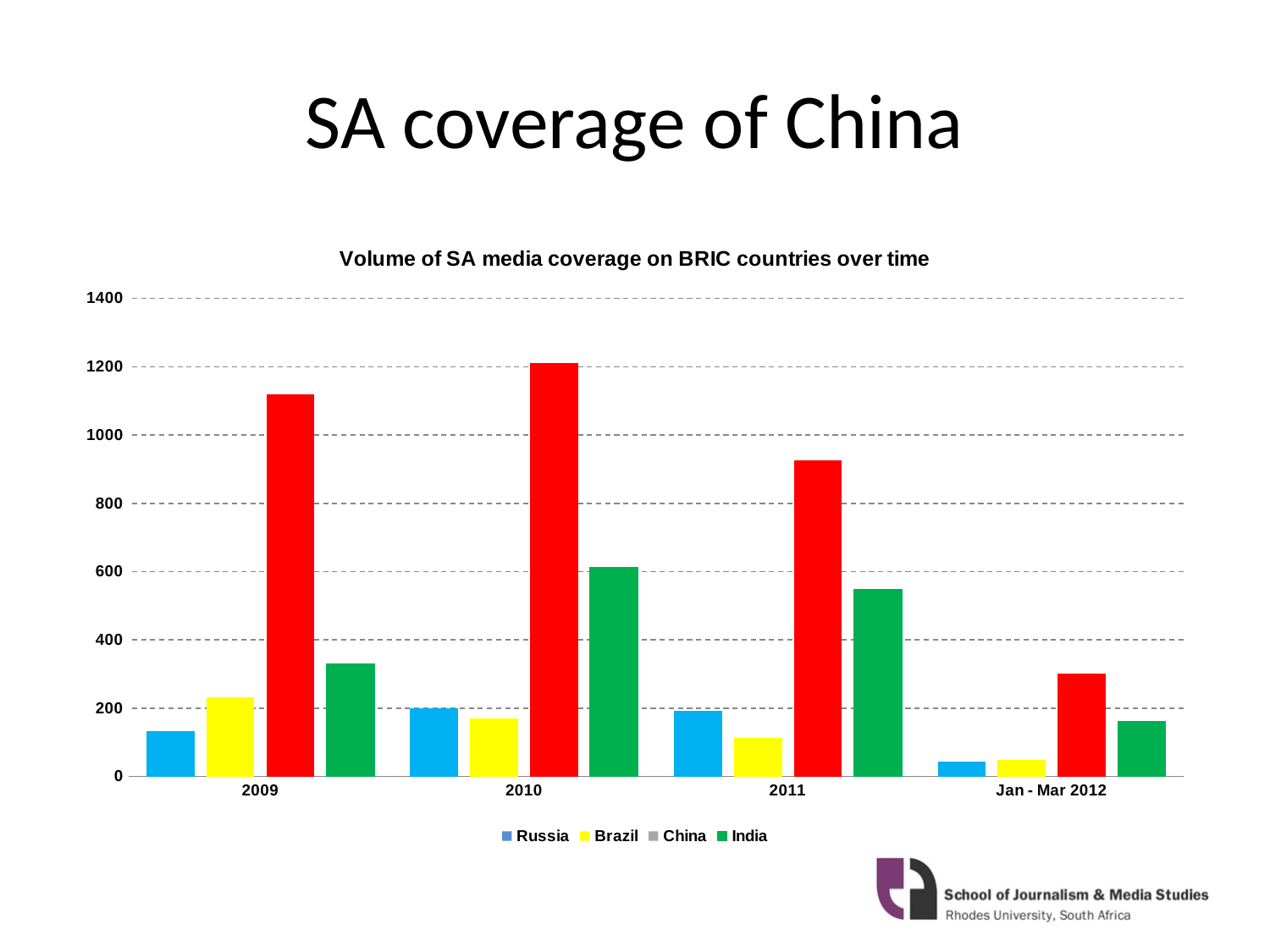
How many series does the legend list? 4 How many time periods are shown along the x axis? 4 What is the title of the chart? Volume of SA media coverage on BRIC countries over time Is the value for India in 2011 greater or less than 600? less What kind of chart is shown on the slide? Bar chart Do the values for China rise or fall from 2010 to Jan - Mar 2012? fall In which period is the China bar the tallest? 2010 Which is larger in 2010, the value for India or the value for Brazil? India Which country has the lowest volume of coverage in 2011? Brazil Is the value for China in 2009 greater or less than 1000? greater Which country has the highest volume of coverage in 2010? China Is the value for China in Jan - Mar 2012 greater or less than 200? greater